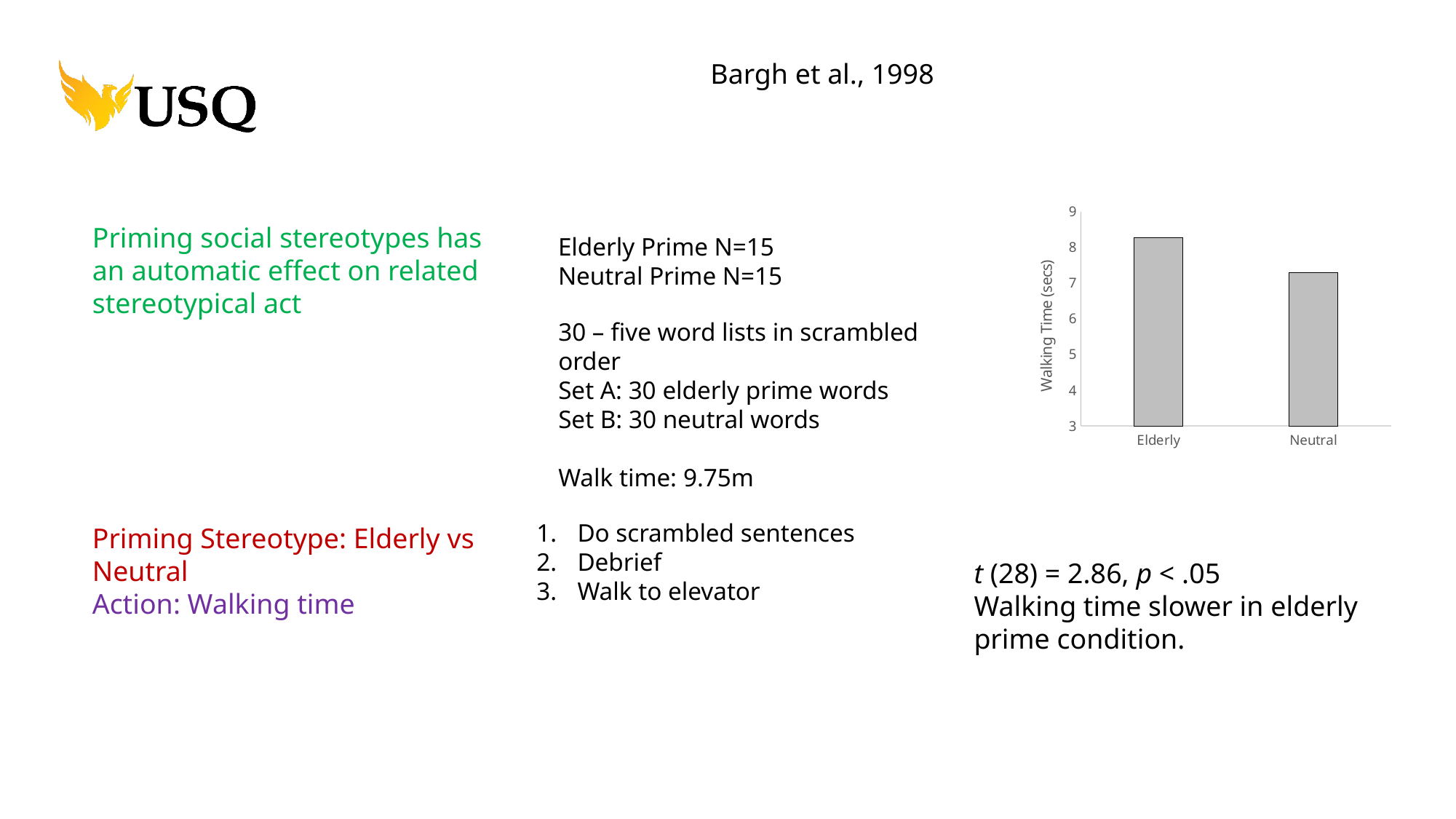
What kind of chart is shown on the slide? bar chart Which category has the lowest walking time in the chart? Neutral Is the value for Neutral greater or less than 7? greater What is the label on the y axis of the chart? Walking Time (secs) Which category has the highest walking time in the chart? Elderly Which bar is taller, Elderly or Neutral? Elderly What is the lowest value shown on the y axis of the chart? 3 Is the value for Elderly greater or less than 8? greater Do the bar values rise or fall moving from Elderly to Neutral along the x axis? fall Is the value for Elderly greater or less than 9? less How many categories are plotted on the x axis of the chart? 2